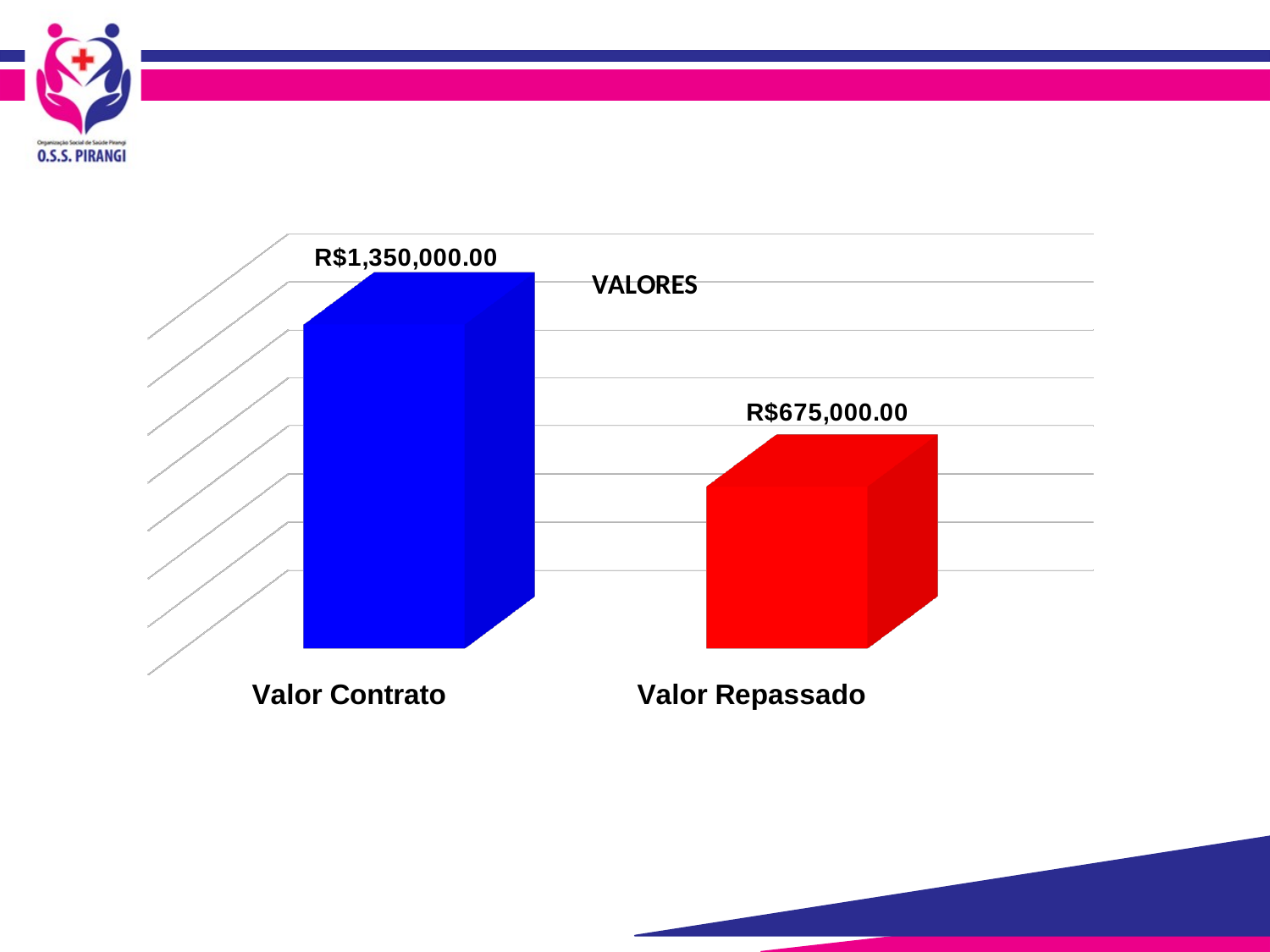
What is the total of Valor Contrato and Valor Repassado? R$2,025,000.00 What is the title of the chart? VALORES Which is larger, Valor Contrato or Valor Repassado? Valor Contrato What is the value for Valor Contrato? R$1,350,000.00 Which category has the highest value? Valor Contrato What kind of chart is shown on the slide? Bar chart What colour is the bar for Valor Repassado? Red What is the difference between Valor Contrato and Valor Repassado? R$675,000.00 What is the value for Valor Repassado? R$675,000.00 Which category has the lowest value? Valor Repassado How many categories are shown in the chart? 2